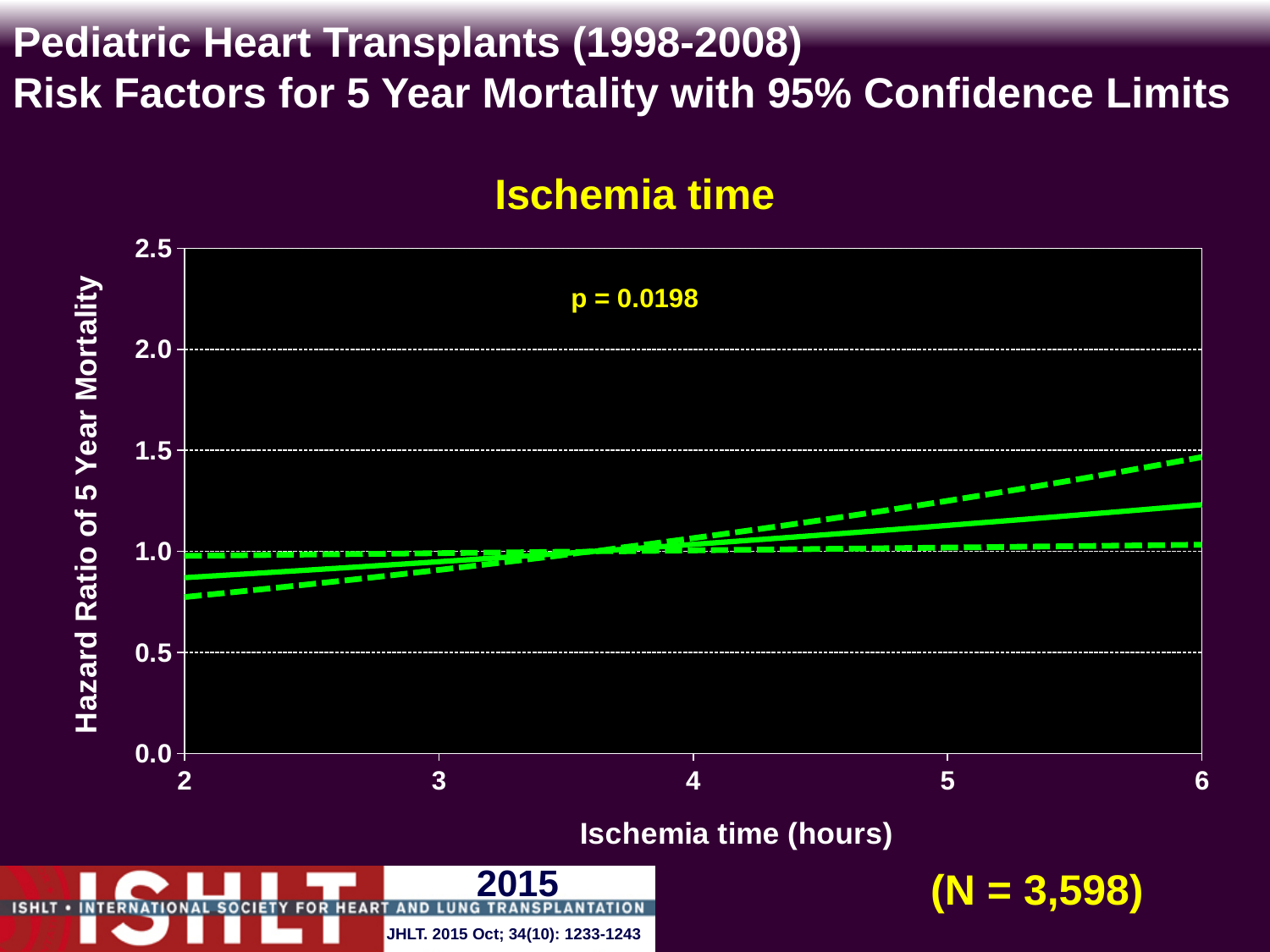
What is the highest value shown on the y axis? 2.5 Is the hazard ratio (solid line) at an ischemia time of 6 hours greater or less than 1.0? greater What kind of chart is shown on the slide? line chart What is the p-value shown on the chart? p = 0.0198 Does the hazard ratio of 5 year mortality rise or fall as ischemia time increases from 2 to 6 hours? rise Is the lower 95% confidence limit (lower dashed line) at an ischemia time of 2 hours greater or less than 1.0? less What is the label of the x axis? Ischemia time (hours) Is the hazard ratio (solid line) at an ischemia time of 6 hours greater or less than 1.5? less How many lines are plotted on the chart? 3